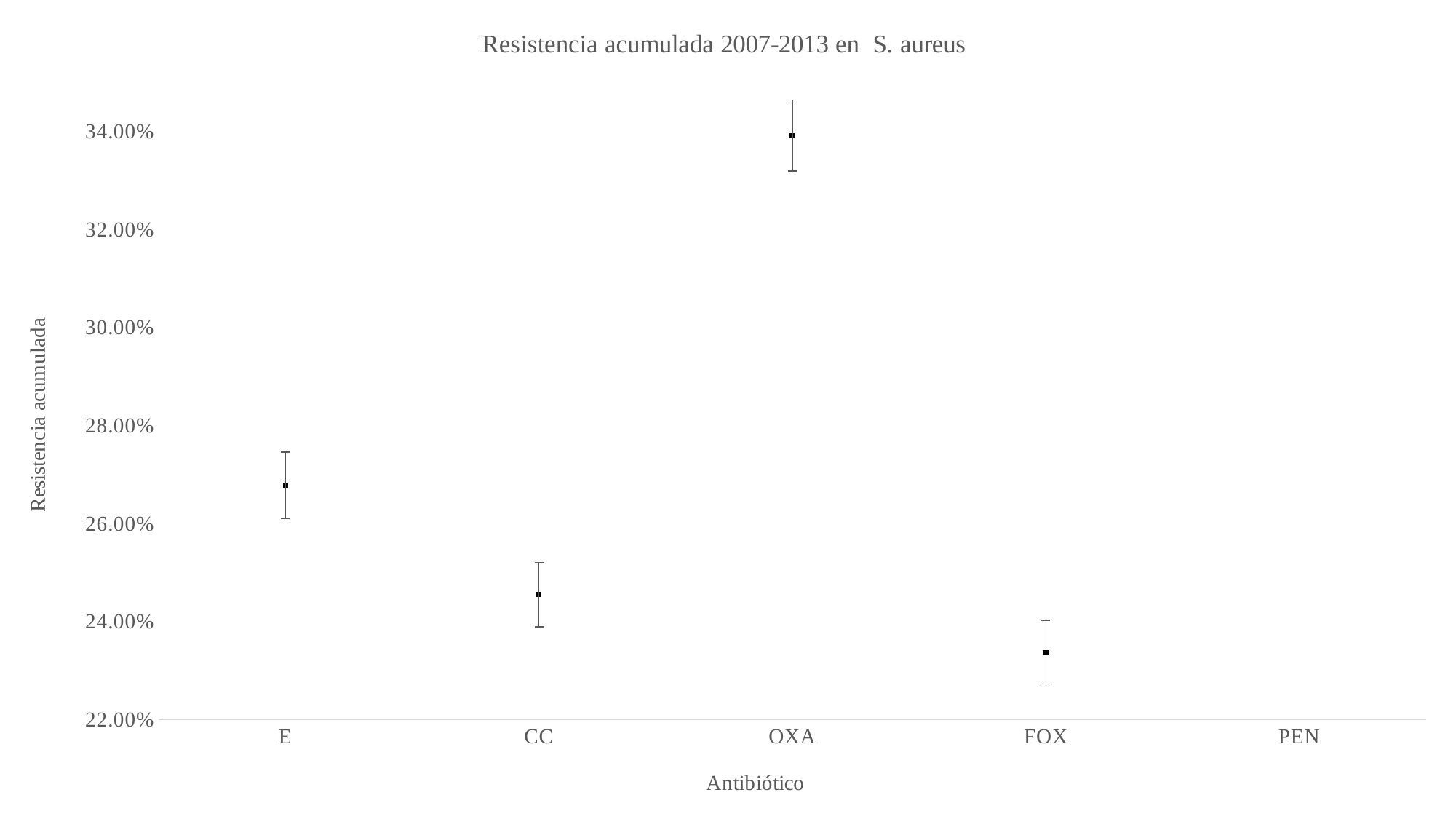
Is the value for OXA greater or less than 32.00%? greater Which antibiotic has the highest plotted resistance value? OXA What kind of chart is shown on the slide? A scatter (point) chart with error bars Which antibiotic has the lowest plotted resistance value? FOX Is the value for CC greater or less than 26.00%? less What is the label of the x axis? Antibiótico What is the title of the chart? Resistencia acumulada 2007-2013 en S. aureus Is the value for E greater or less than 26.00%? greater Which has a higher resistance value, CC or FOX? CC How many antibiotic categories are labelled on the x axis? 5 Which has a higher resistance value, E or CC? E